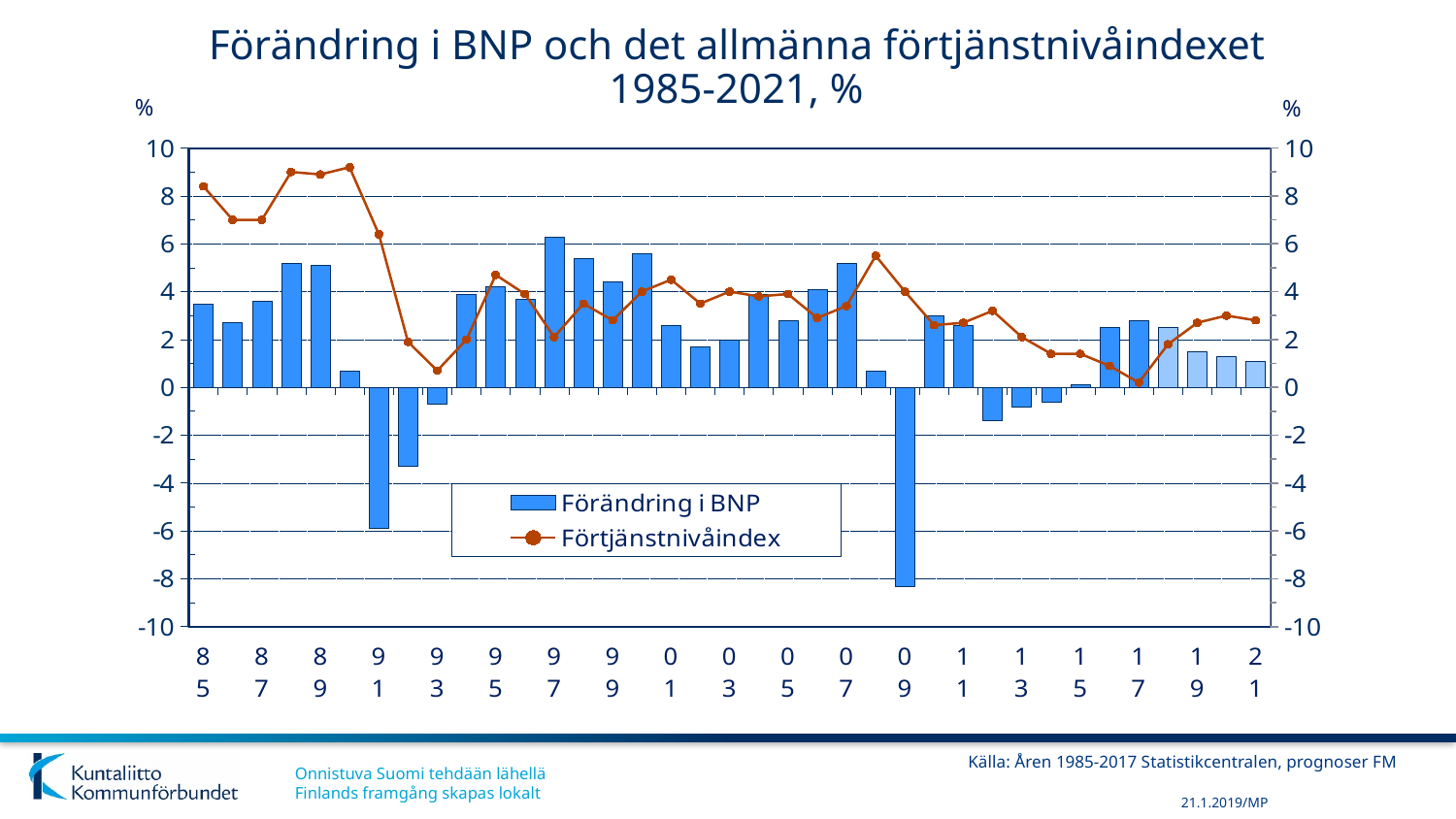
Is the Förändring i BNP value for 2009 greater or less than -6? less Does the Förtjänstnivåindex line rise or fall from 1985 to 1993? fall Is the Förtjänstnivåindex value for 1985 greater or less than 8? greater Is the Förändring i BNP value for 1997 greater or less than 4? greater In which year is the Förändring i BNP bar lowest? 2009 In which year is the Förtjänstnivåindex line at its lowest point? 2017 What kind of chart is shown on the slide? A combined bar and line chart Which series is drawn as bars? Förändring i BNP How many series does the legend list? 2 Which is larger, the Förtjänstnivåindex value for 1985 or for 2021? 1985 Which series is drawn as a line with markers? Förtjänstnivåindex